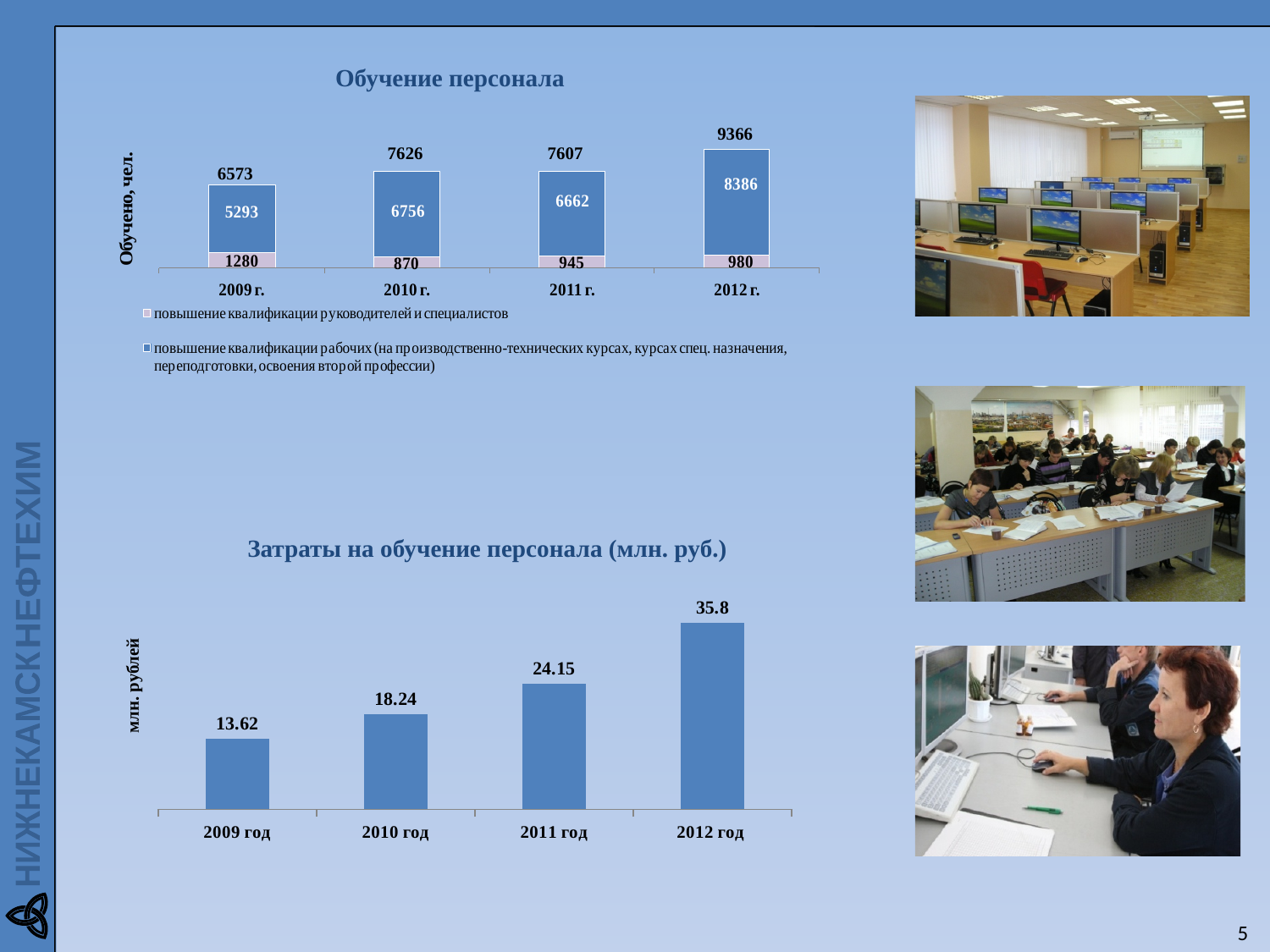
In the 'Обучение персонала' chart, how many руководители и специалисты were trained in 2009 г.? 1280 In the 'Обучение персонала' chart, what is the difference between the number of рабочие trained in 2012 г. and in 2011 г.? 1724 In the 'Затраты на обучение персонала (млн. руб.)' chart, which year has the lowest value? 2009 год In the 'Обучение персонала' chart, how many series does the legend list? 2 In the 'Обучение персонала' chart, how many рабочие were trained in 2011 г.? 6662 In the 'Обучение персонала' chart, which year has the highest total number of people trained? 2012 г. In the 'Обучение персонала' chart, what is the total number of people trained in 2012 г.? 9366 In the 'Обучение персонала' chart, which year has the lowest number of руководители и специалисты trained? 2010 г. What kind of chart is the 'Затраты на обучение персонала (млн. руб.)' chart? bar chart In the 'Затраты на обучение персонала (млн. руб.)' chart, what is the difference between the values for 2012 год and 2009 год? 22.18 In the 'Затраты на обучение персонала (млн. руб.)' chart, what is the value for 2011 год? 24.15 In the 'Затраты на обучение персонала (млн. руб.)' chart, do the values rise or fall from 2009 год to 2012 год? rise